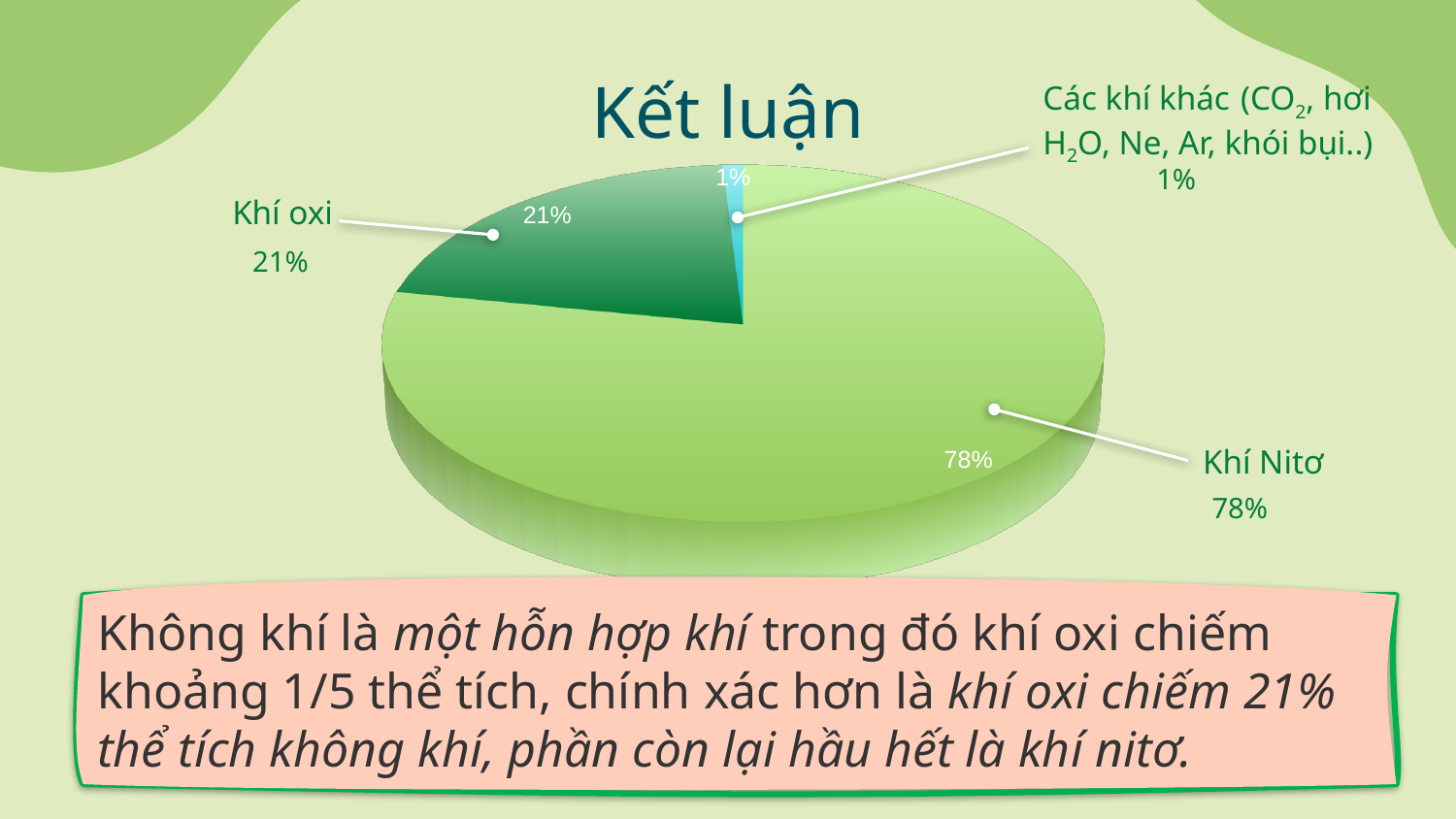
What is the combined share of Khí oxi and Các khí khác? 22% Which slice of the pie chart is the largest? Khí Nitơ Which is larger, the share for Khí oxi or the share for Các khí khác? Khí oxi Which gases are listed in the label for the smallest slice? CO2, hơi H2O, Ne, Ar, khói bụi What percentage of the pie chart does Khí Nitơ represent? 78% What percentage of the pie chart does Khí oxi represent? 21% What percentage of the pie chart do the other gases (Các khí khác) represent? 1% What type of chart is shown on the slide? Pie chart What is the difference in percentage points between Khí Nitơ and Khí oxi? 57 What is the title of the chart? Kết luận Which slice of the pie chart is the smallest? Các khí khác How many slices does the pie chart have? 3